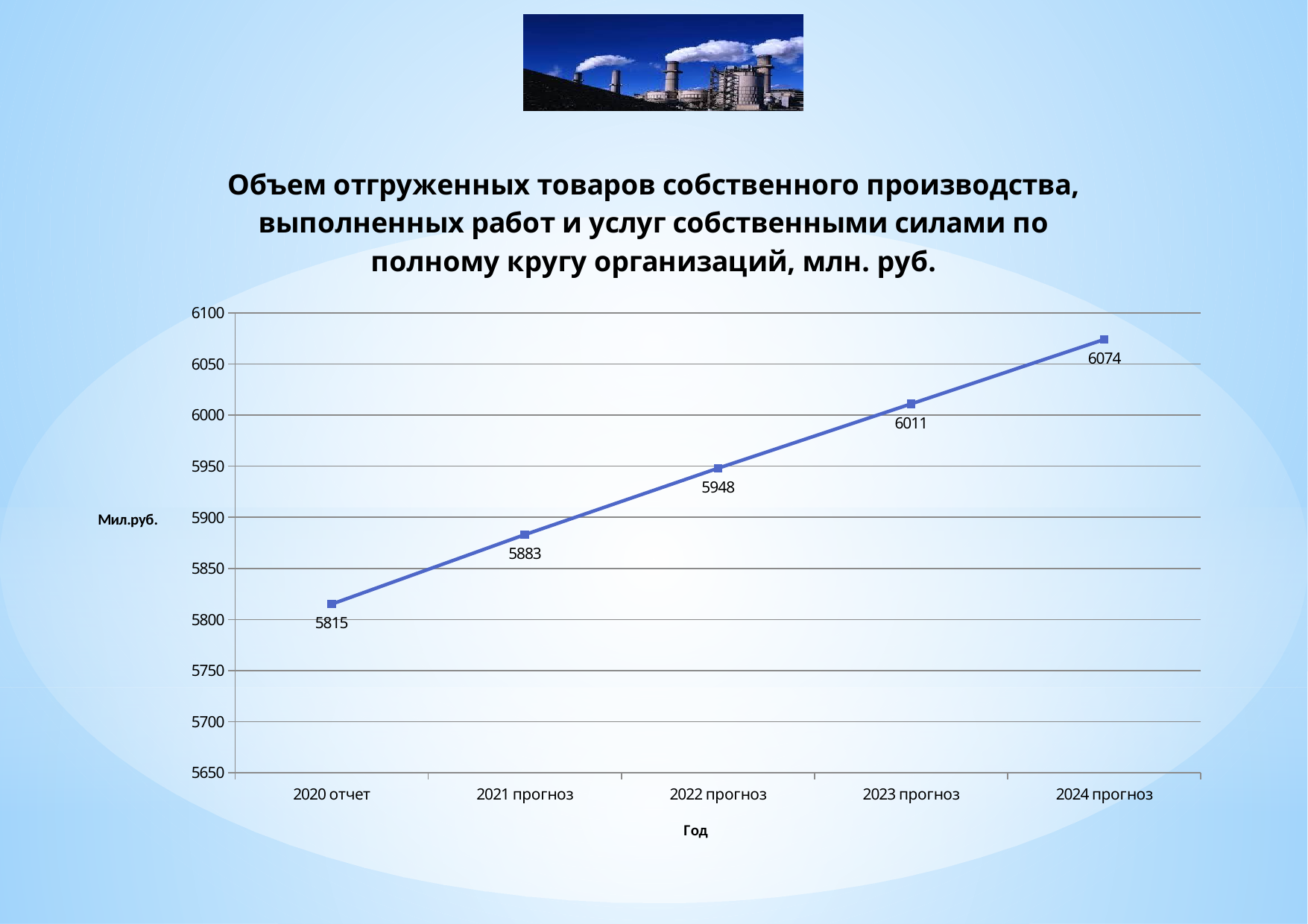
What is the value for 2020 отчет? 5815 What kind of chart is shown on the slide? line chart What is the value for 2024 прогноз? 6074 Which year has the highest value? 2024 прогноз Do the values rise or fall from 2020 to 2024? rise Is the value for 2021 прогноз greater or less than 5900? less What is the difference between the values for 2023 прогноз and 2022 прогноз? 63 What is the difference between the values for 2024 прогноз and 2020 отчет? 259 How many data points are plotted on the chart? 5 What is the value for 2022 прогноз? 5948 Which year has the lowest value? 2020 отчет Which is larger, the value for 2021 прогноз or the value for 2023 прогноз? 2023 прогноз